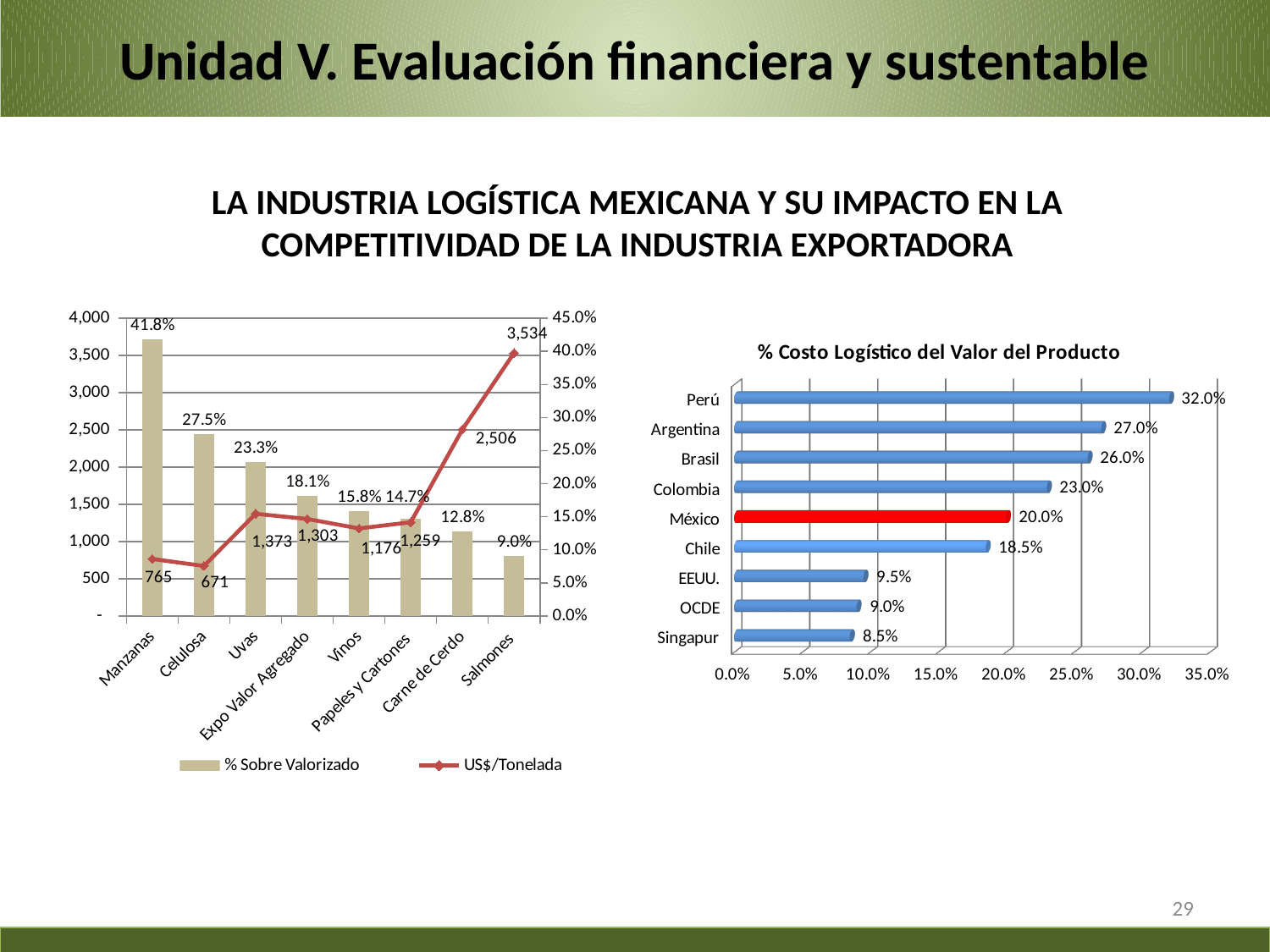
In the chart on the left, what is the % Sobre Valorizado value for Manzanas? 41.8% In the chart titled '% Costo Logístico del Valor del Producto', which bar is coloured red? México In the chart on the left, which category has the lowest % Sobre Valorizado value? Salmones In the chart titled '% Costo Logístico del Valor del Producto', what is the difference between the values for Perú and Chile? 13.5% In the chart on the left, which category has the highest US$/Tonelada value? Salmones In the chart on the left, is the US$/Tonelada value for Celulosa or for Uvas larger? Uvas In the chart on the left, how many series does the legend list? 2 In the chart titled '% Costo Logístico del Valor del Producto', which category has the lowest value? Singapur In the chart titled '% Costo Logístico del Valor del Producto', how many categories are shown? 9 In the chart titled '% Costo Logístico del Valor del Producto', which country has the highest value? Perú In the chart titled '% Costo Logístico del Valor del Producto', what is the value for México? 20.0% In the chart on the left, what is the US$/Tonelada value for Salmones? 3,534